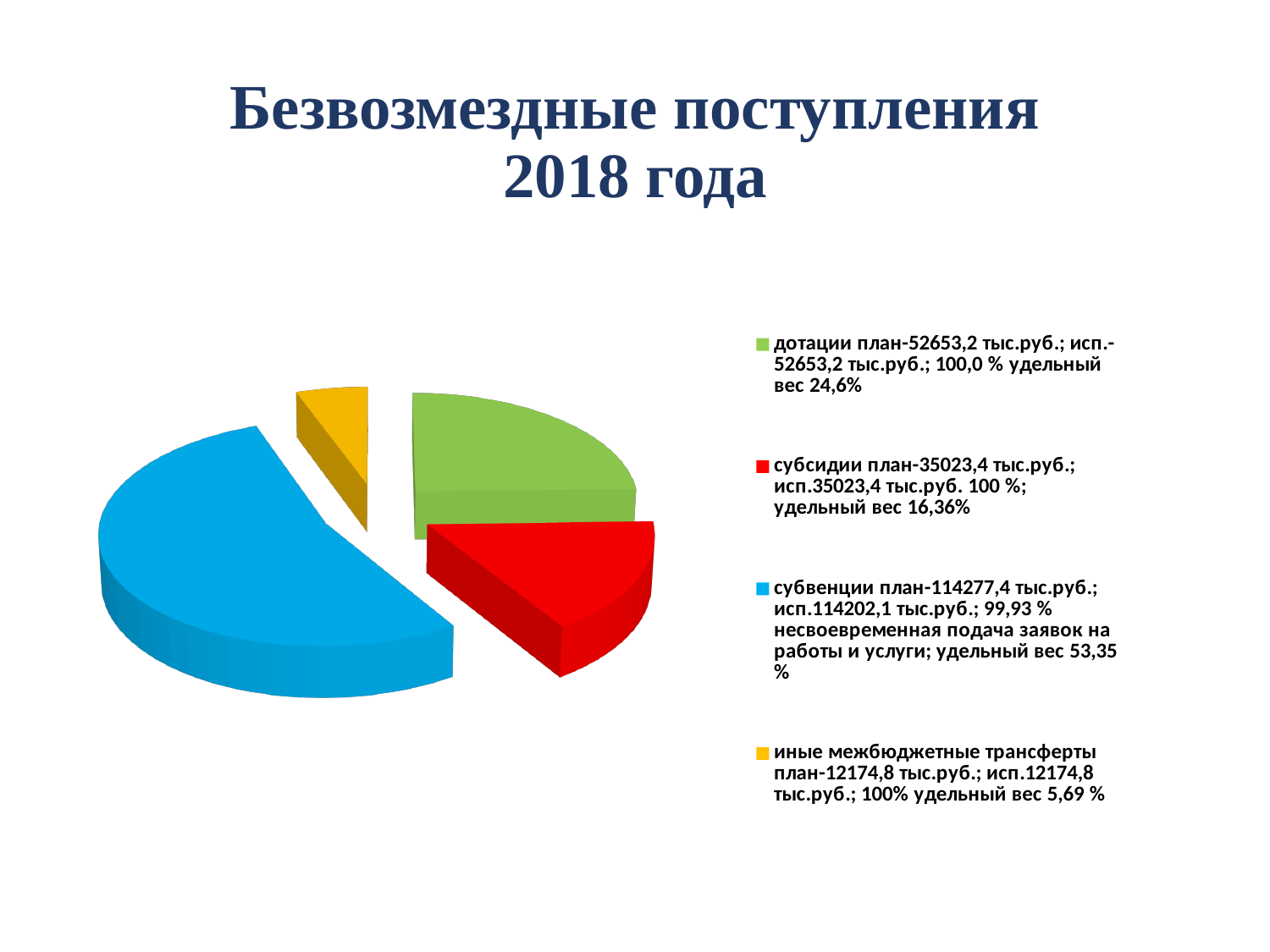
What is the title of the slide containing the chart? Безвозмездные поступления 2018 года According to the legend, what is the share (удельный вес) of субвенции? 53,35 % How many entries does the legend list? 4 Which category has the smallest slice of the pie? иные межбюджетные трансферты According to the legend, what is the executed amount (исп.) for субвенции? 114202,1 тыс.руб. How many slices does the pie chart have? 4 What colour is the slice for иные межбюджетные трансферты? yellow According to the legend, what is the planned amount (план) for субсидии? 35023,4 тыс.руб. According to the legend, what is the share (удельный вес) of дотации? 24,6% Which slice is larger, дотации or субсидии? дотации Which category has the largest slice of the pie? субвенции What kind of chart is shown on the slide? pie chart